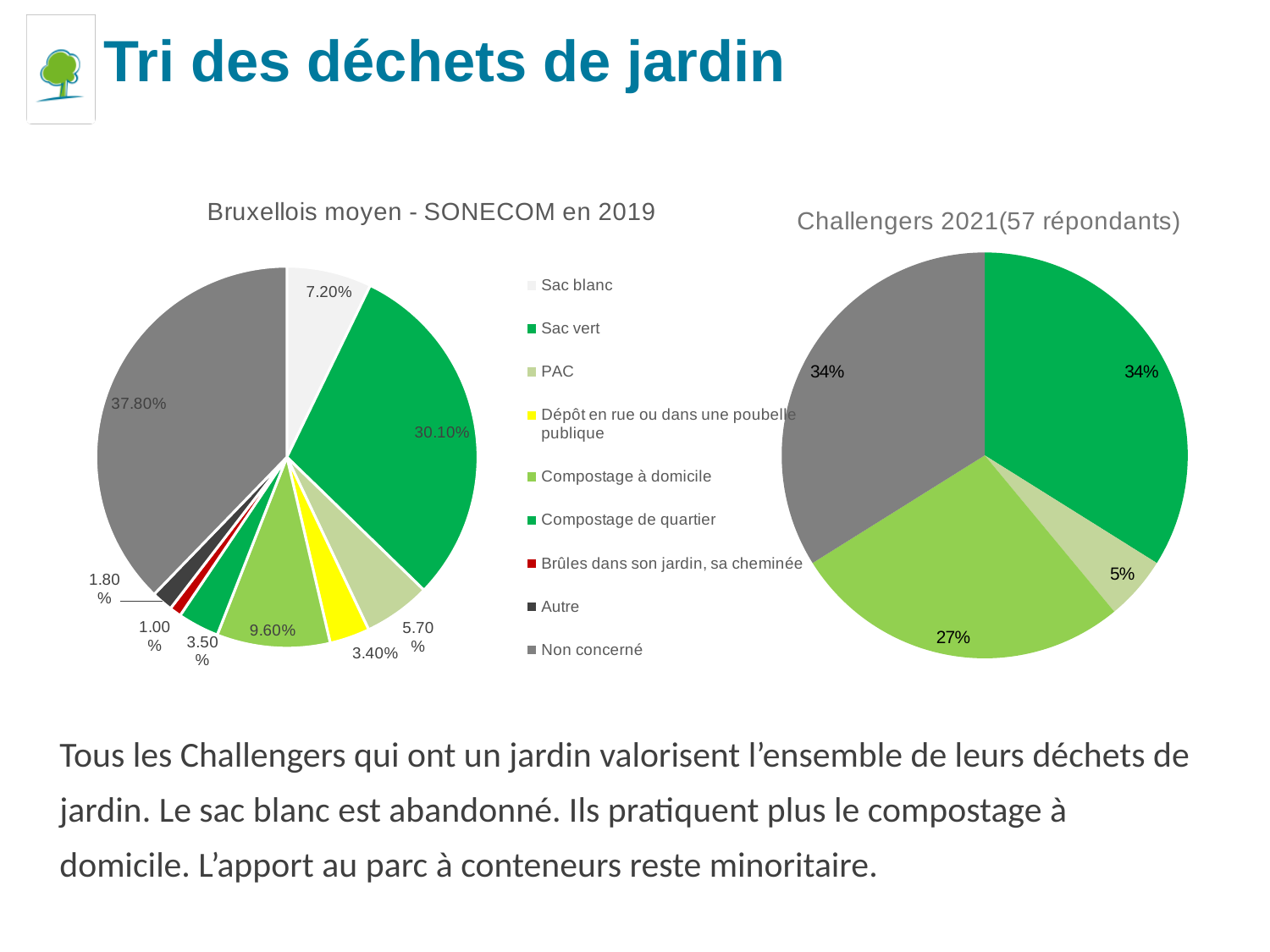
In the 'Bruxellois moyen - SONECOM en 2019' chart, what percentage is shown for 'Sac blanc'? 7.20% In the 'Bruxellois moyen - SONECOM en 2019' chart, what is the difference between the 'Non concerné' share and the 'Sac vert' share? 7.70% In the 'Bruxellois moyen - SONECOM en 2019' chart, what percentage is shown for 'Sac vert'? 30.10% In the 'Challengers 2021(57 répondants)' chart, which category has the smallest slice? PAC In the 'Challengers 2021(57 répondants)' chart, what share is shown for 'Compostage à domicile'? 27% In the 'Bruxellois moyen - SONECOM en 2019' chart, what share is labelled for the 'Non concerné' slice? 37.80% How many entries does the legend between the two charts list? 9 What type of chart is used for 'Bruxellois moyen - SONECOM en 2019'? Pie chart In the 'Challengers 2021(57 répondants)' chart, which is larger: 'Compostage à domicile' or 'PAC'? Compostage à domicile How many slices does the 'Challengers 2021(57 répondants)' chart have? 4 In the 'Bruxellois moyen - SONECOM en 2019' chart, which category has the largest slice? Non concerné In the 'Bruxellois moyen - SONECOM en 2019' chart, which category has the smallest slice? Brûles dans son jardin, sa cheminée